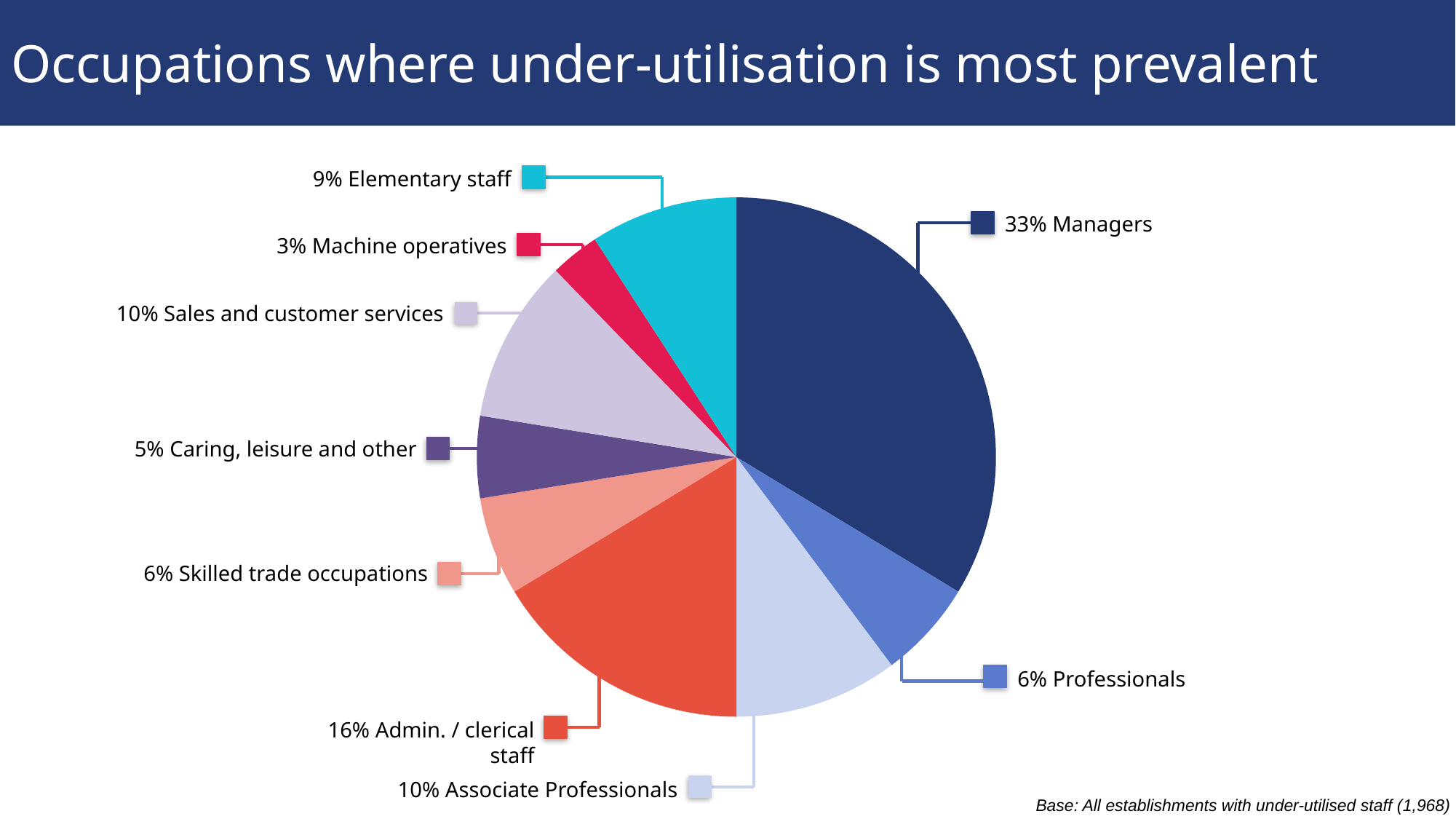
Which is larger, the share for Sales and customer services or the share for Caring, leisure and other? Sales and customer services What percentage is shown for Elementary staff? 9% What percentage is shown for Machine operatives? 3% What is the title of the slide? Occupations where under-utilisation is most prevalent What is the difference in percentage points between Managers and Admin. / clerical staff? 17 What percentage is shown for Admin. / clerical staff? 16% Which occupation has the largest slice of the pie? Managers What share of the pie is Managers? 33% How many occupation categories are shown in the pie chart? 9 What is the base stated for the chart? All establishments with under-utilised staff (1,968) Which occupation has the smallest slice of the pie? Machine operatives What kind of chart is shown on the slide? Pie chart